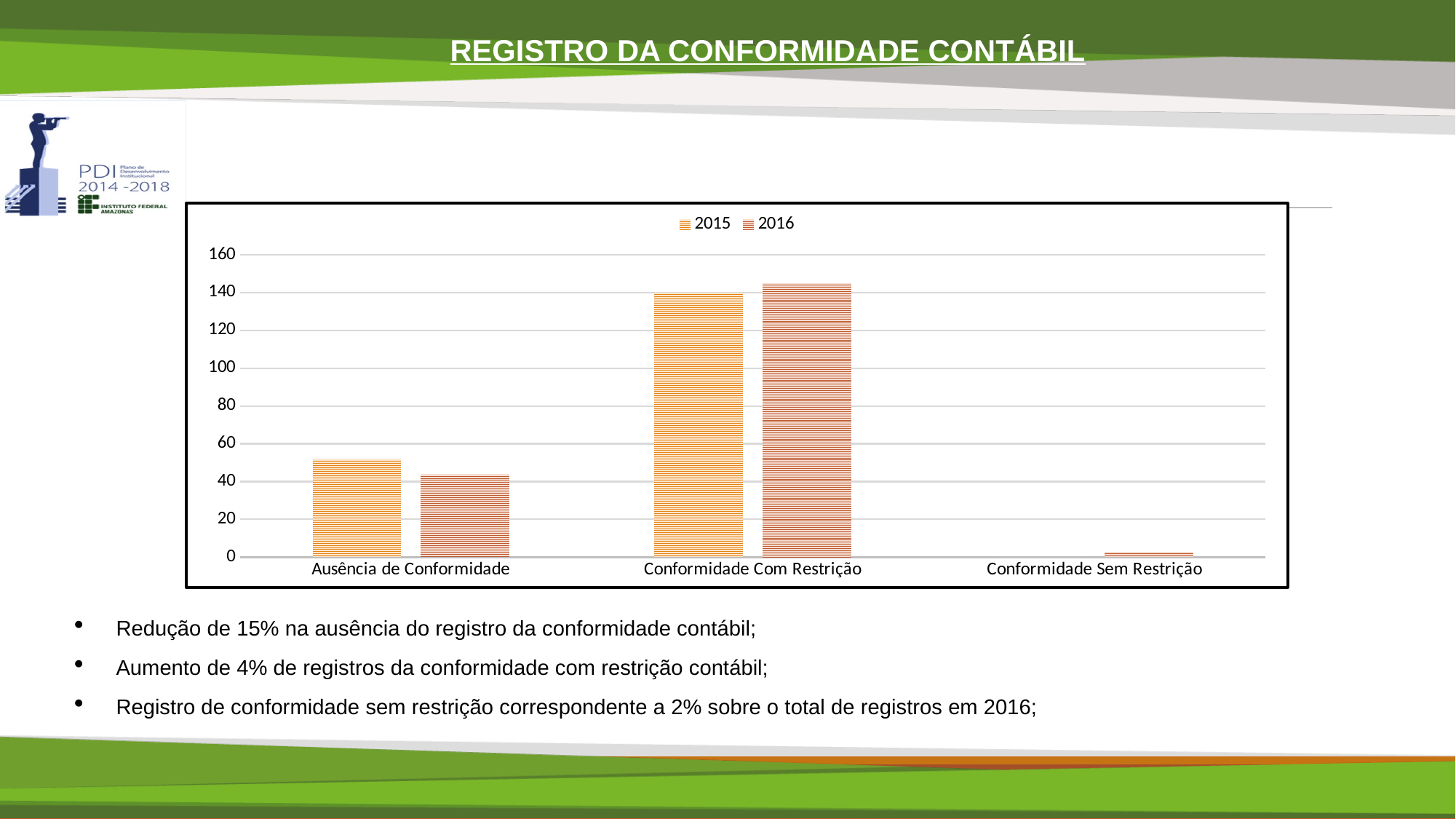
What kind of chart is shown on the slide? bar chart For Conformidade Com Restrição, which year has the larger value, 2015 or 2016? 2016 What is the title of the slide containing the chart? REGISTRO DA CONFORMIDADE CONTÁBIL Is the 2016 value for Conformidade Sem Restrição greater or less than 20? less Is the 2015 value for Conformidade Com Restrição greater or less than 120? greater Which category has the lowest value for 2016? Conformidade Sem Restrição For Ausência de Conformidade, which year has the larger value, 2015 or 2016? 2015 How many categories are shown on the x axis of the chart? 3 Which category has the highest value for 2015? Conformidade Com Restrição Is the 2015 value for Ausência de Conformidade greater or less than 60? less Which years are listed in the chart legend? 2015 and 2016 How many series does the legend list? 2